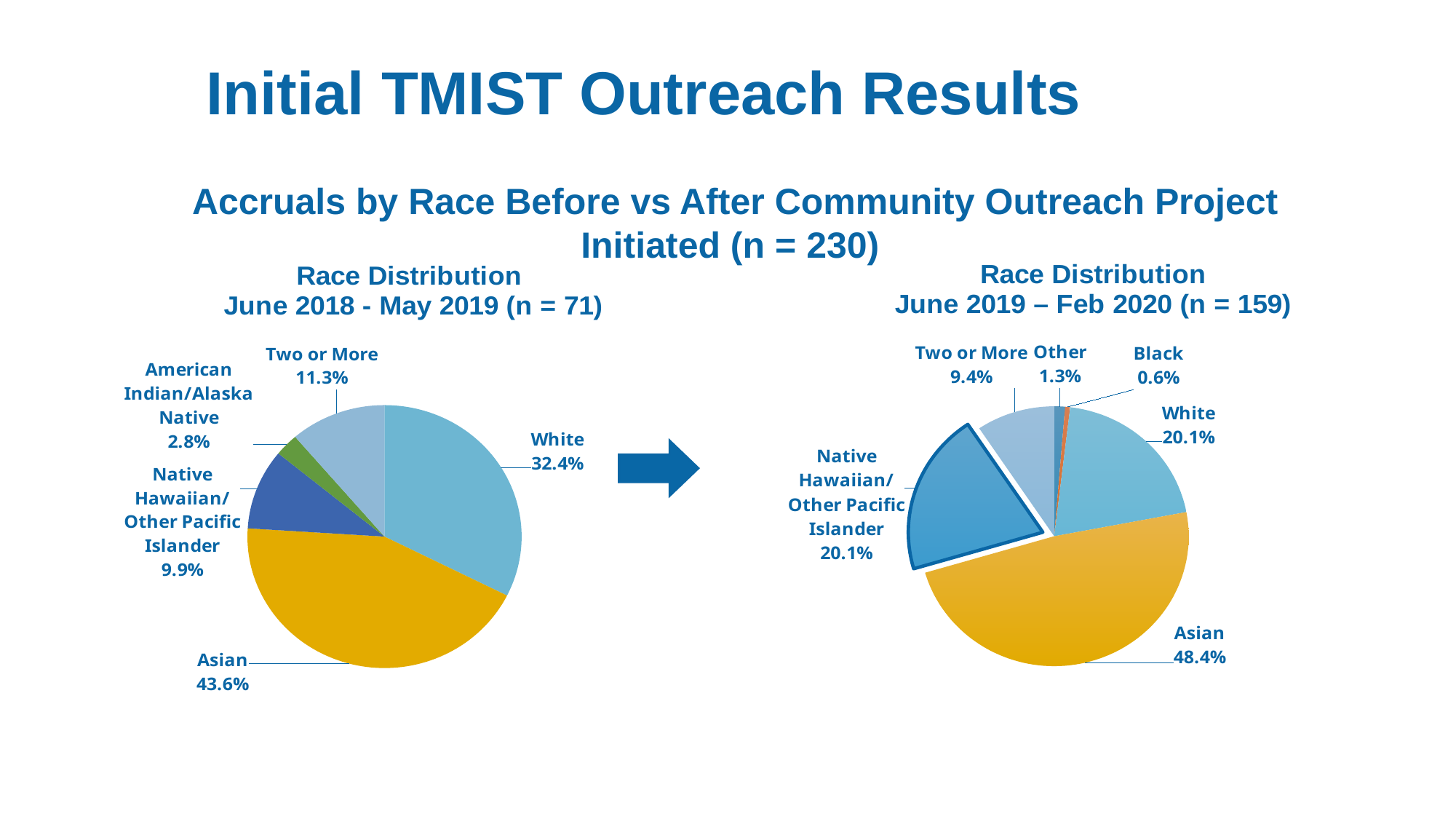
What is the difference between the Asian share in the right pie chart (48.4%) and the Asian share in the left pie chart (43.6%)? 4.8% In the right pie chart (June 2019 – Feb 2020), what share of accruals is Asian? 48.4% What is the sample size (n) stated in the title of the right pie chart? 159 In the left pie chart (June 2018 - May 2019), which category has the smallest share? American Indian/Alaska Native How many race categories are shown in the left pie chart (June 2018 - May 2019)? 5 In the left pie chart (June 2018 - May 2019), which is larger: the share for Two or More or the share for Native Hawaiian/Other Pacific Islander? Two or More What type of chart is used to show the race distributions on this slide? Pie chart In the left pie chart (June 2018 - May 2019), what share of accruals is White? 32.4% In the left pie chart (June 2018 - May 2019), which race category has the largest share? Asian In the right pie chart (June 2019 – Feb 2020), what share is Native Hawaiian/Other Pacific Islander? 20.1% In the right pie chart (June 2019 – Feb 2020), which race category has the smallest share? Black How many race categories are shown in the right pie chart (June 2019 – Feb 2020)? 6